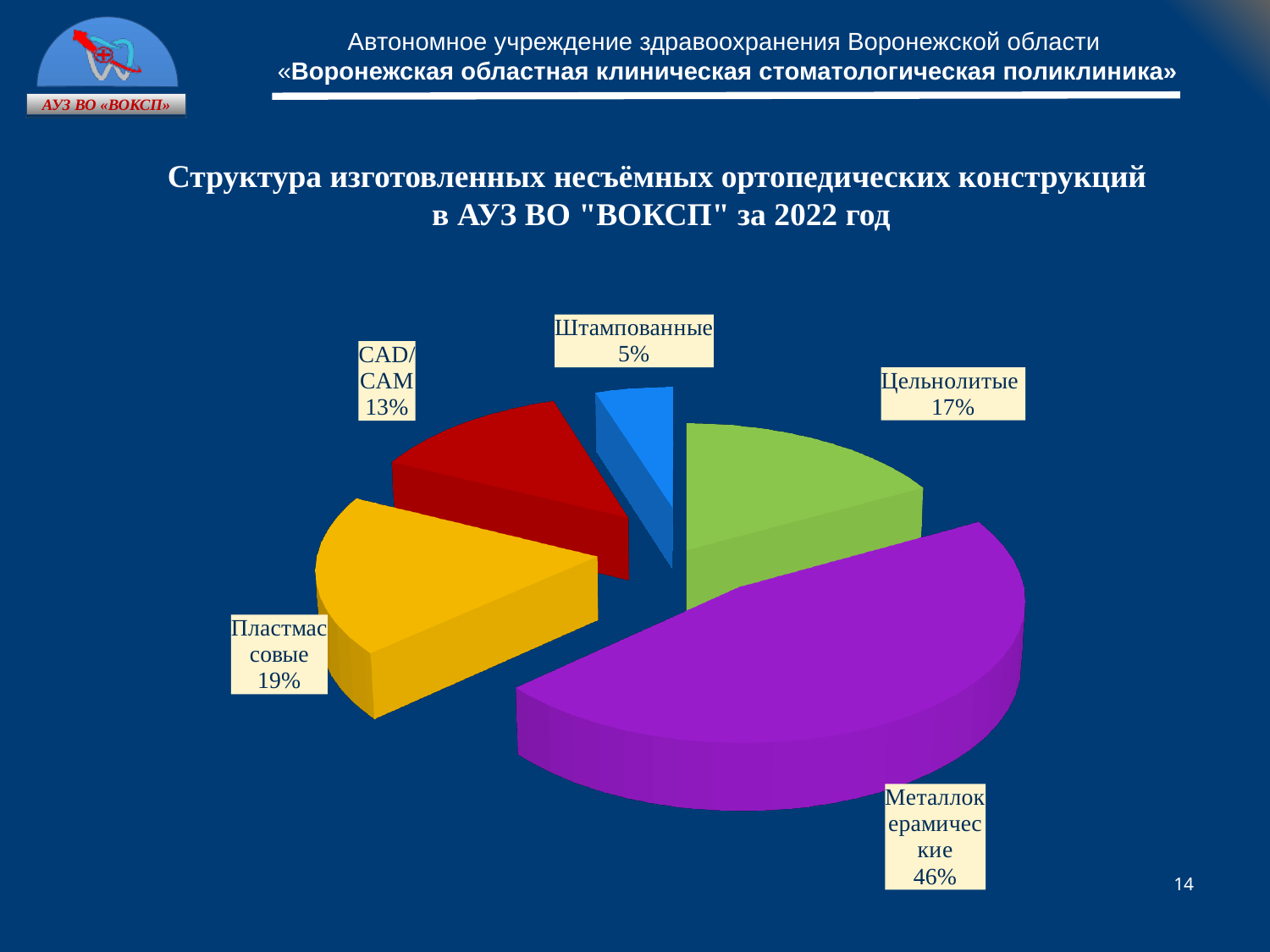
What colour is the slice for Пластмассовые? yellow What kind of chart is shown on the slide? pie chart What is the difference in percentage points between Металлокерамические and Пластмассовые? 27 What share of the pie does CAD/CAM have? 13% What share of the pie does Цельнолитые have? 17% What share of the pie does Штампованные have? 5% Which category has the smallest share of the pie? Штампованные Which is larger, the share for Цельнолитые or the share for CAD/CAM? Цельнолитые How many categories are shown in the pie chart? 5 Which category has the largest share of the pie? Металлокерамические